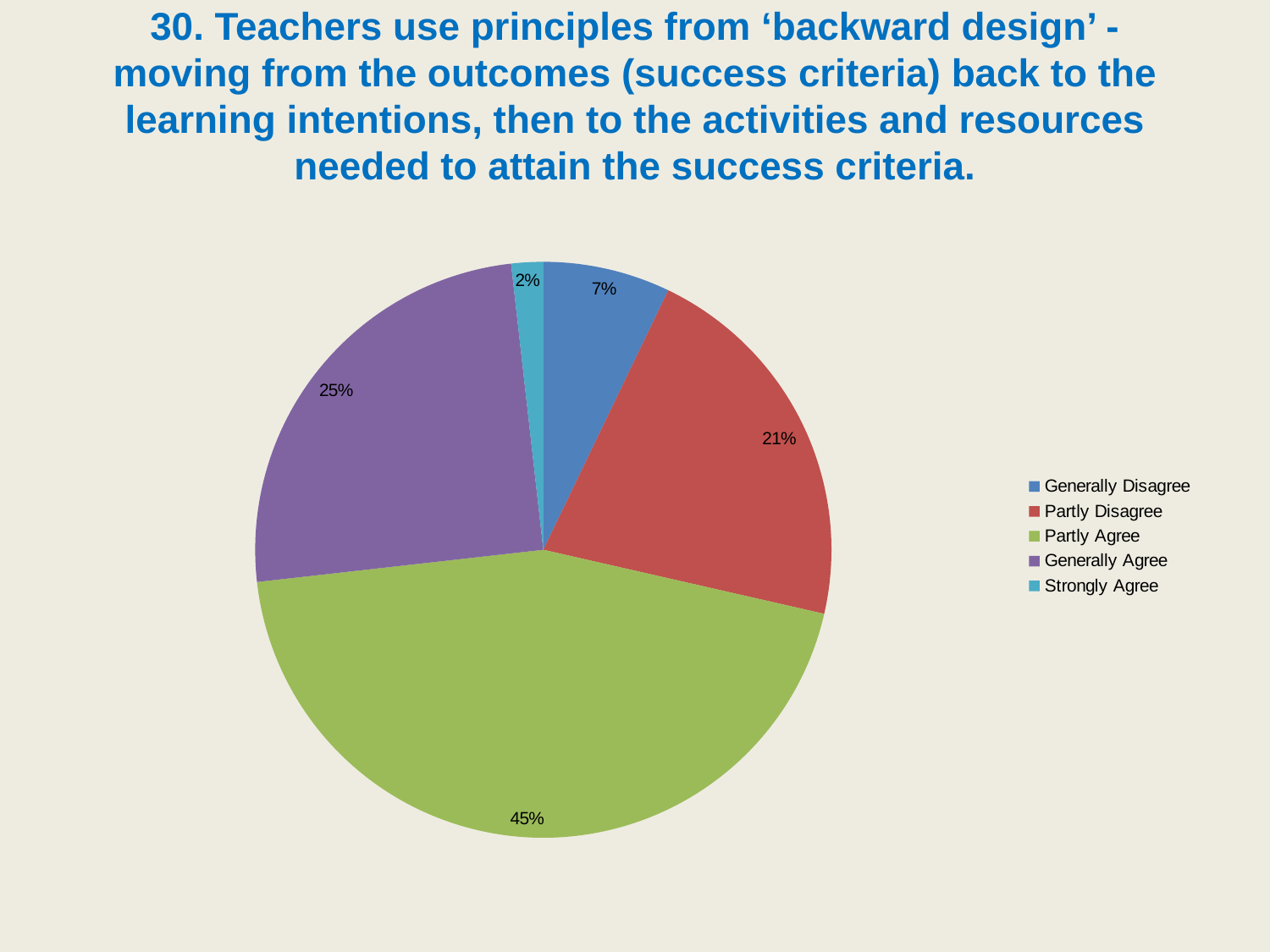
What percentage of respondents chose Generally Disagree? 7% What percentage of respondents chose Partly Agree? 45% What kind of chart is shown on the slide? pie chart What is the difference in percentage points between Partly Agree and Generally Agree? 20 What percentage of respondents chose Partly Disagree? 21% Which is larger, the share for Partly Disagree or the share for Generally Agree? Generally Agree What is the combined share of Generally Agree and Strongly Agree? 27% Which response category has the smallest share of the pie? Strongly Agree How many response categories does the legend list? 5 Which response category has the largest share of the pie? Partly Agree Which colour represents Partly Agree in the pie chart? green What percentage of respondents chose Strongly Agree? 2%